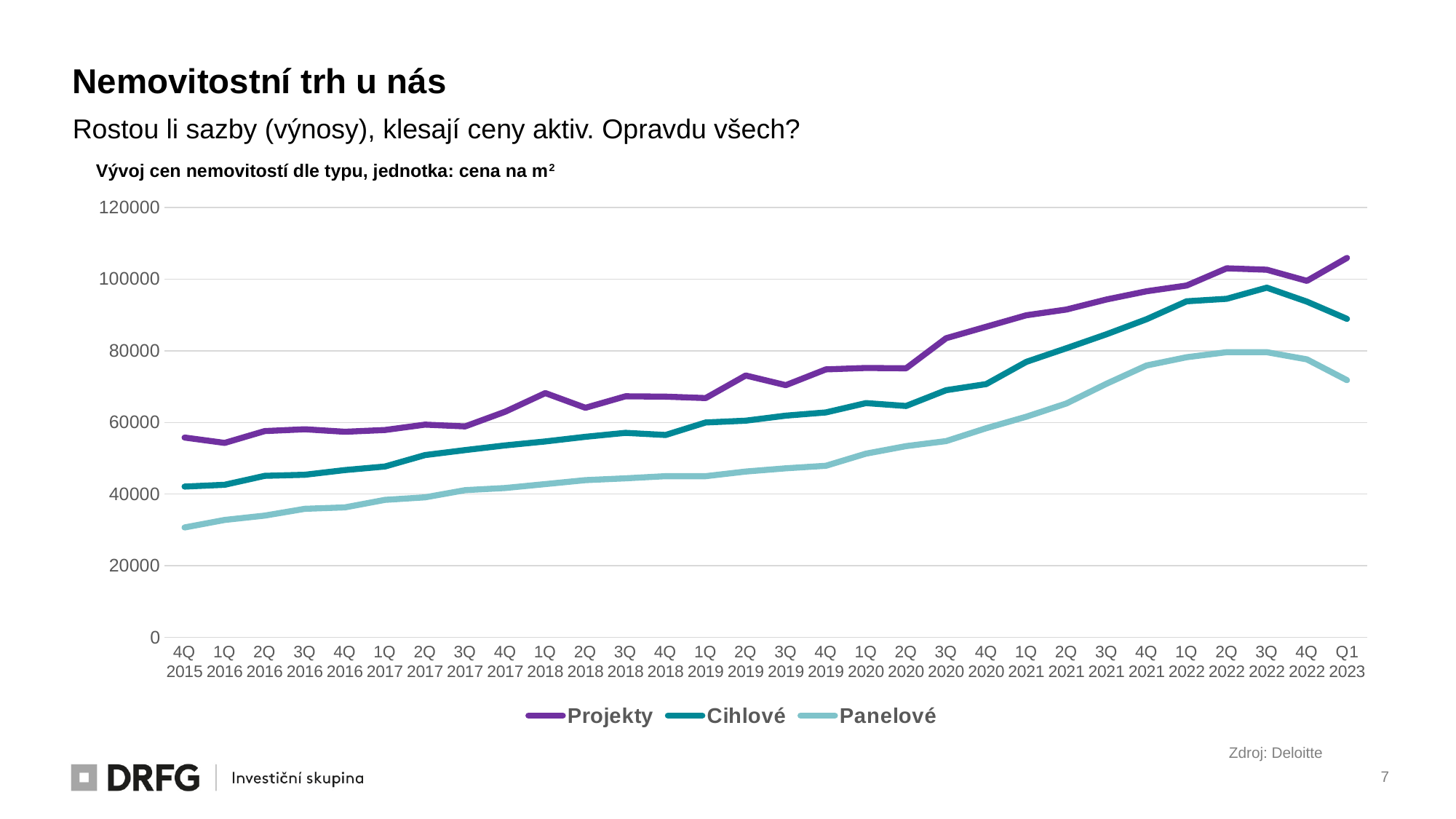
Is the value for Projekty in Q1 2023 greater or less than 100000? greater Is the value for Cihlové in Q1 2023 greater or less than 100000? less Does the Cihlové series rise or fall between 3Q 2022 and Q1 2023? fall How many series does the legend list? 3 Is the value for Panelové in Q1 2023 greater or less than 80000? less What is the title of the chart? Vývoj cen nemovitostí dle typu, jednotka: cena na m² Which is larger in Q1 2023, the value for Projekty or the value for Cihlové? Projekty Which series is plotted with the lowest values across the whole period? Panelové What kind of chart is shown on the slide? line chart Which series is plotted with the highest values across the whole period? Projekty